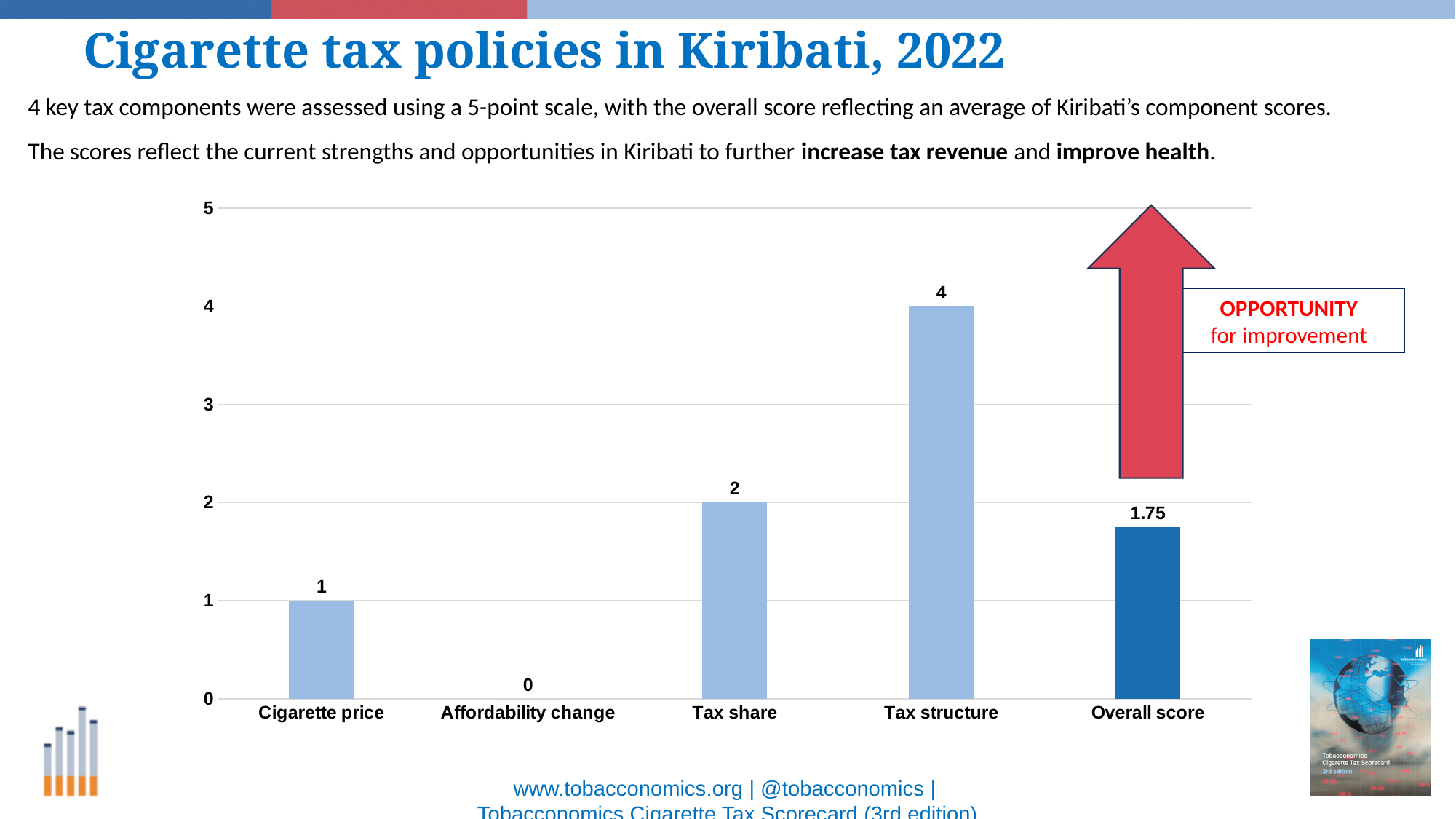
What is the difference between the Tax structure score and the Tax share score? 2 What is the score for Tax structure? 4 Which is larger, the score for Tax share or the score for Cigarette price? Tax share How many categories are shown on the x axis? 5 Which category has the highest score? Tax structure Is the Overall score greater or less than 2? less What is the score for Affordability change? 0 What kind of chart is shown on the slide? bar chart What is the score for Cigarette price? 1 What is the Overall score? 1.75 What is the maximum value shown on the y axis? 5 Which category has the lowest score? Affordability change